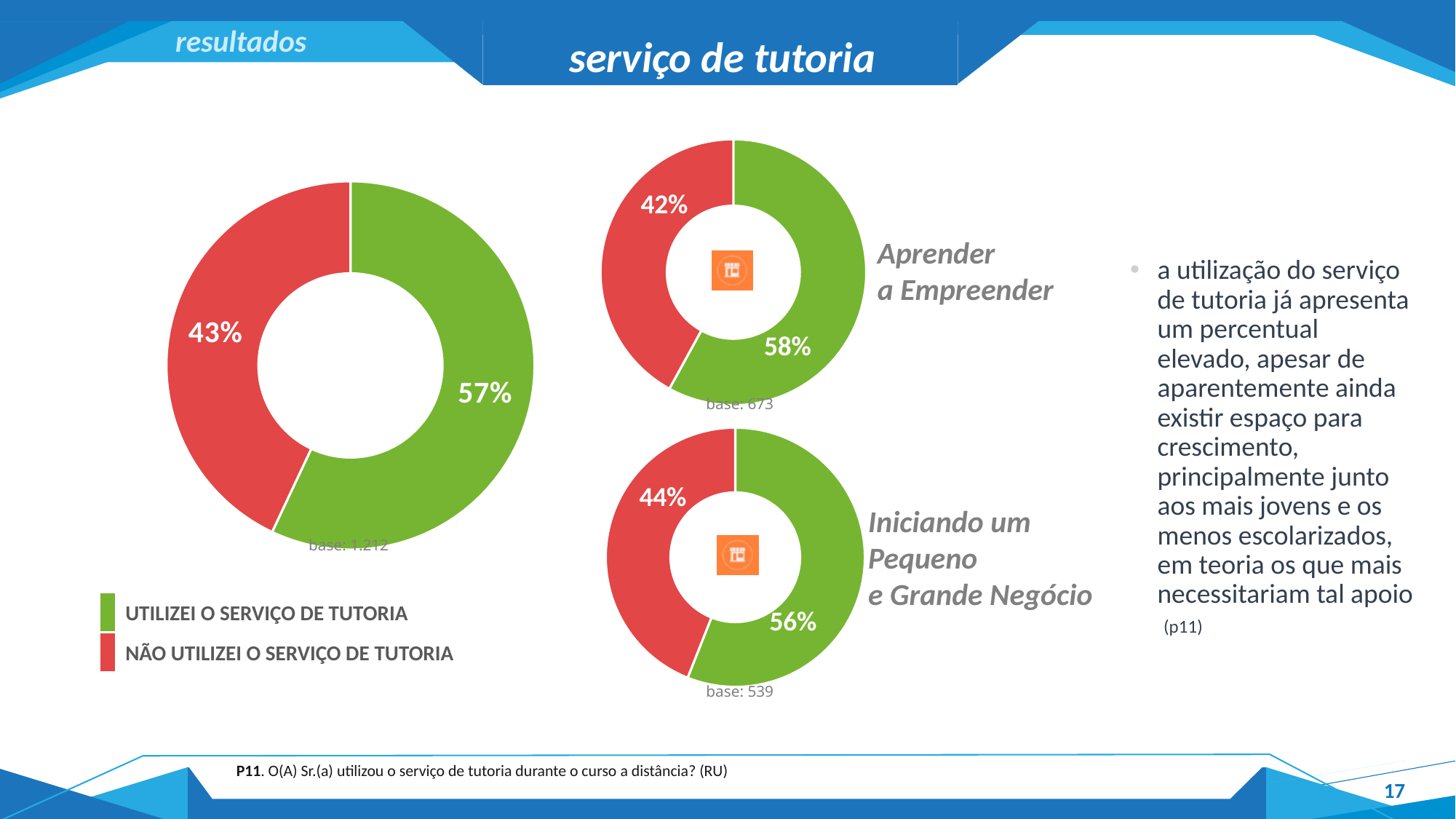
In the Iniciando um Pequeno e Grande Negócio donut chart, what share used the tutoring service (green slice)? 56% In the Aprender a Empreender donut chart, which slice is larger: used the tutoring service or did not use it? Used the tutoring service (58%) What colour represents respondents who did not use the tutoring service? Red In the Aprender a Empreender donut chart, what share used the tutoring service (green slice)? 58% In the Aprender a Empreender donut chart, what share did not use the tutoring service (red slice)? 42% What type of chart is used to show the tutoring service results on this slide? Donut (pie) chart In the large donut chart on the left, what is the difference between the share that used and the share that did not use the tutoring service? 14% In the large donut chart on the left, what percentage did not use the tutoring service (NÃO UTILIZEI O SERVIÇO DE TUTORIA)? 43% Which course has the higher share of respondents who used the tutoring service: Aprender a Empreender or Iniciando um Pequeno e Grande Negócio? Aprender a Empreender How many categories does the legend list for the charts on this slide? 2 In the large donut chart on the left, what percentage of respondents used the tutoring service (UTILIZEI O SERVIÇO DE TUTORIA)? 57% In the Iniciando um Pequeno e Grande Negócio donut chart, what share did not use the tutoring service (red slice)? 44%